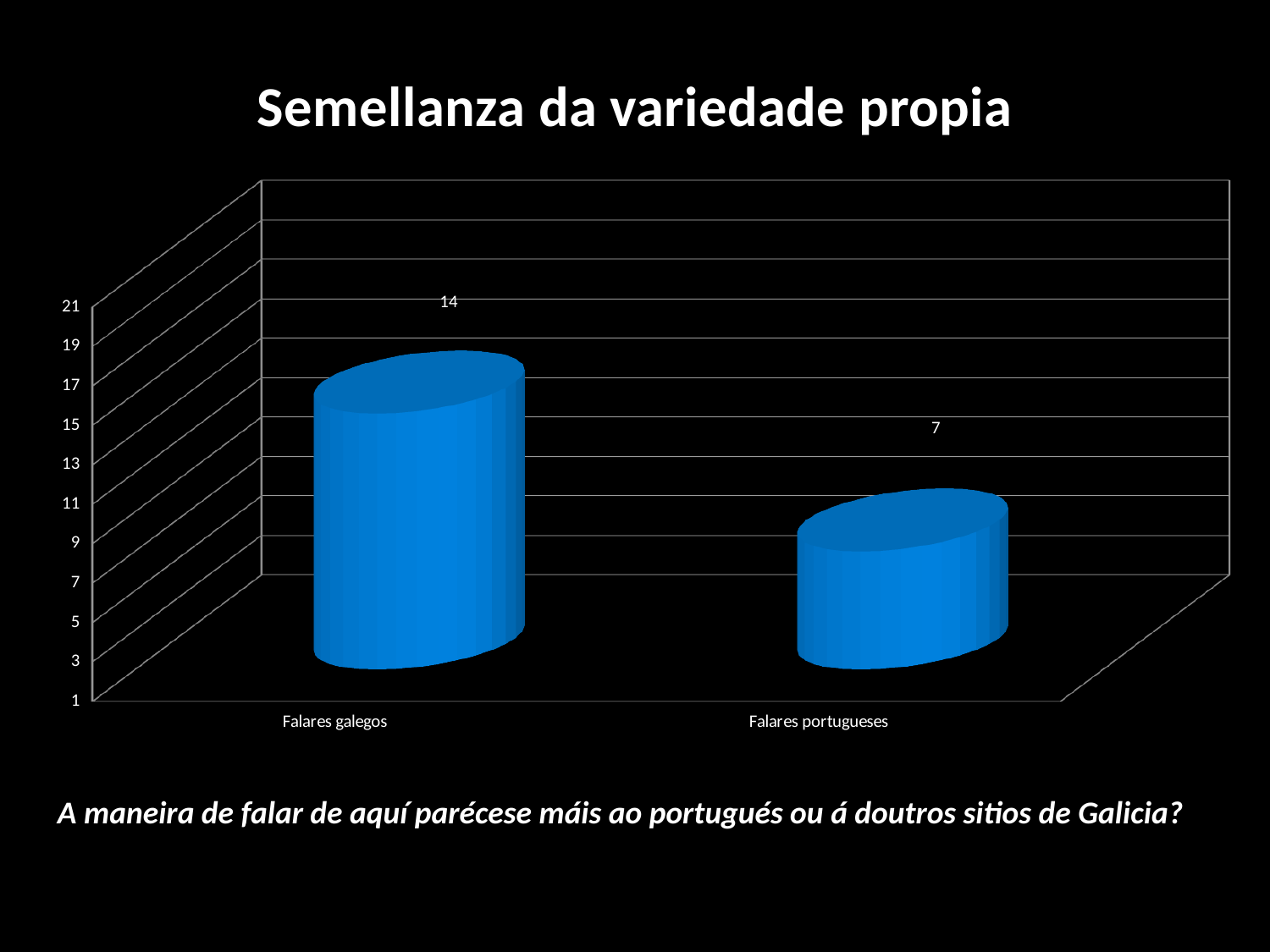
What colour are the bars in the chart? blue Which category has the lowest value? Falares portugueses Which category has the highest value? Falares galegos Which is larger, the value for Falares galegos or the value for Falares portugueses? Falares galegos What is the value for Falares galegos? 14 Is the value for Falares portugueses greater or less than 9? less What is the title of the chart? Semellanza da variedade propia What kind of chart is shown on the slide? bar chart What is the value for Falares portugueses? 7 What is the difference between the values for Falares galegos and Falares portugueses? 7 How many categories are shown on the chart? 2 Is the value for Falares galegos greater or less than 11? greater